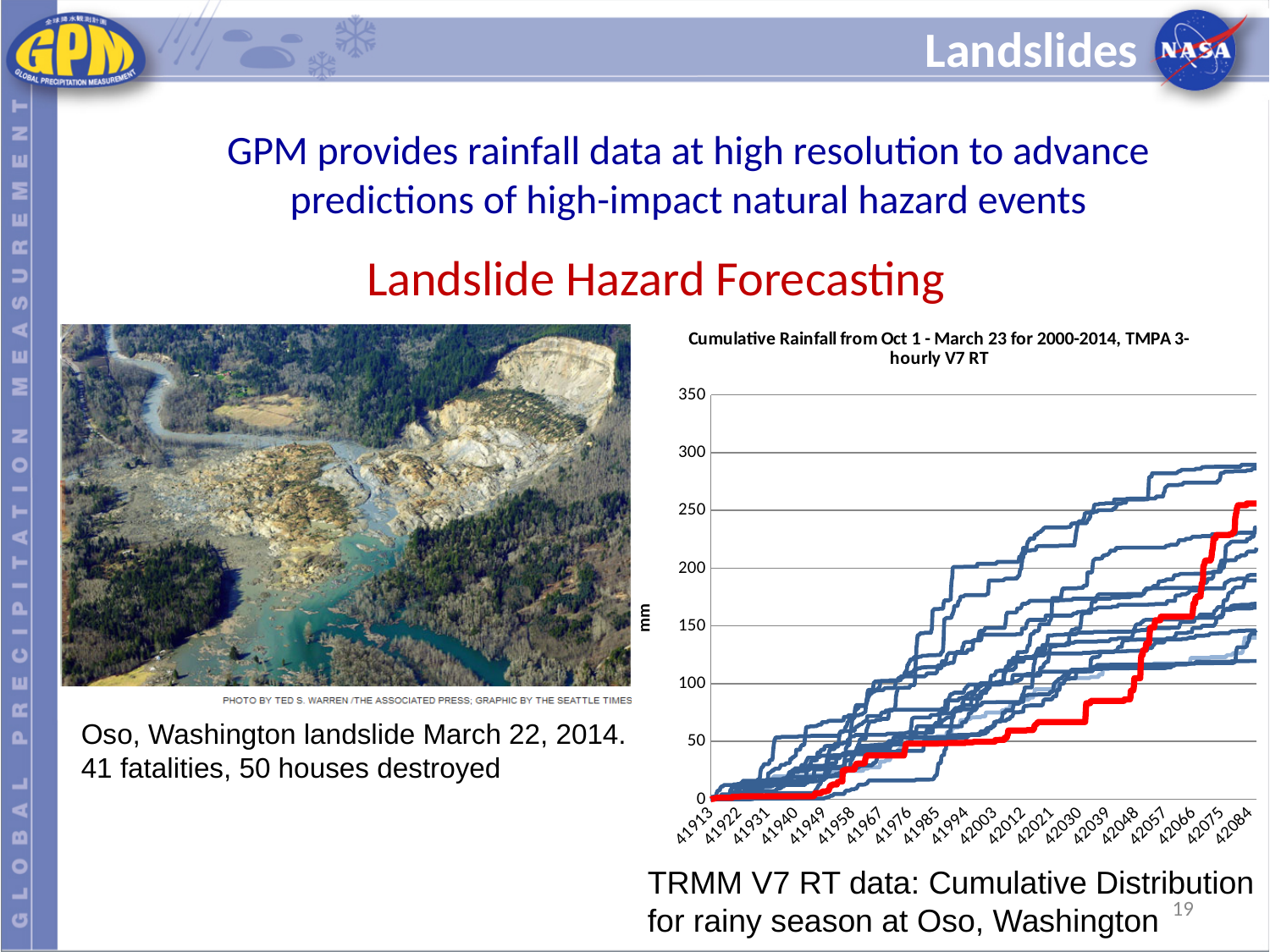
Is the final value of the highest line in the chart greater or less than 300? less What kind of chart is shown on the slide? line chart Is the value of the red line at x = 42030 greater or less than 100? less Is the final value of the highest line in the chart greater or less than 250? greater What is the last tick label on the horizontal axis of the chart? 42084 How many tick labels are shown on the horizontal axis of the chart? 20 What is the highest value shown on the vertical axis of the chart? 350 What is the title of the chart? Cumulative Rainfall from Oct 1 - March 23 for 2000-2014, TMPA 3-hourly V7 RT What is the label on the vertical axis of the chart? mm What is the first tick label on the horizontal axis of the chart? 41913 Do the lines in the chart rise or fall as you move from left to right along the x axis? rise